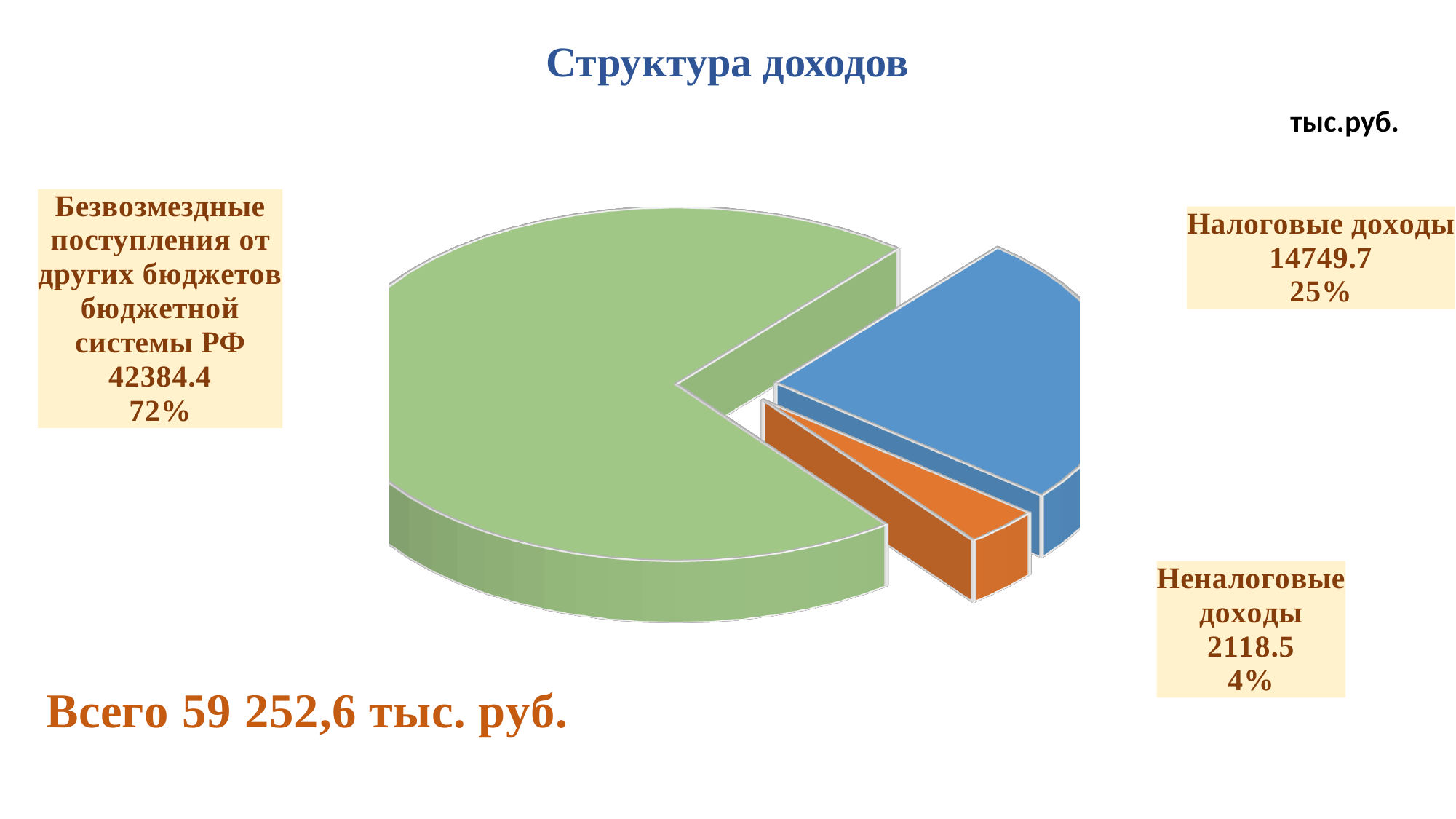
Which is larger, Налоговые доходы or Неналоговые доходы? Налоговые доходы Which category has the largest share of the pie? Безвозмездные поступления от других бюджетов бюджетной системы РФ What type of chart is shown on the slide? pie chart What share of the pie does Безвозмездные поступления от других бюджетов бюджетной системы РФ represent? 72% What is the title of the chart? Структура доходов What is the value for Налоговые доходы? 14749.7 What is the difference between the values for Налоговые доходы and Неналоговые доходы? 12631.2 What share of the pie does Налоговые доходы represent? 25% How many slices does the pie chart have? 3 What is the value for Неналоговые доходы? 2118.5 What is the value for Безвозмездные поступления от других бюджетов бюджетной системы РФ? 42384.4 Which category has the smallest share of the pie? Неналоговые доходы